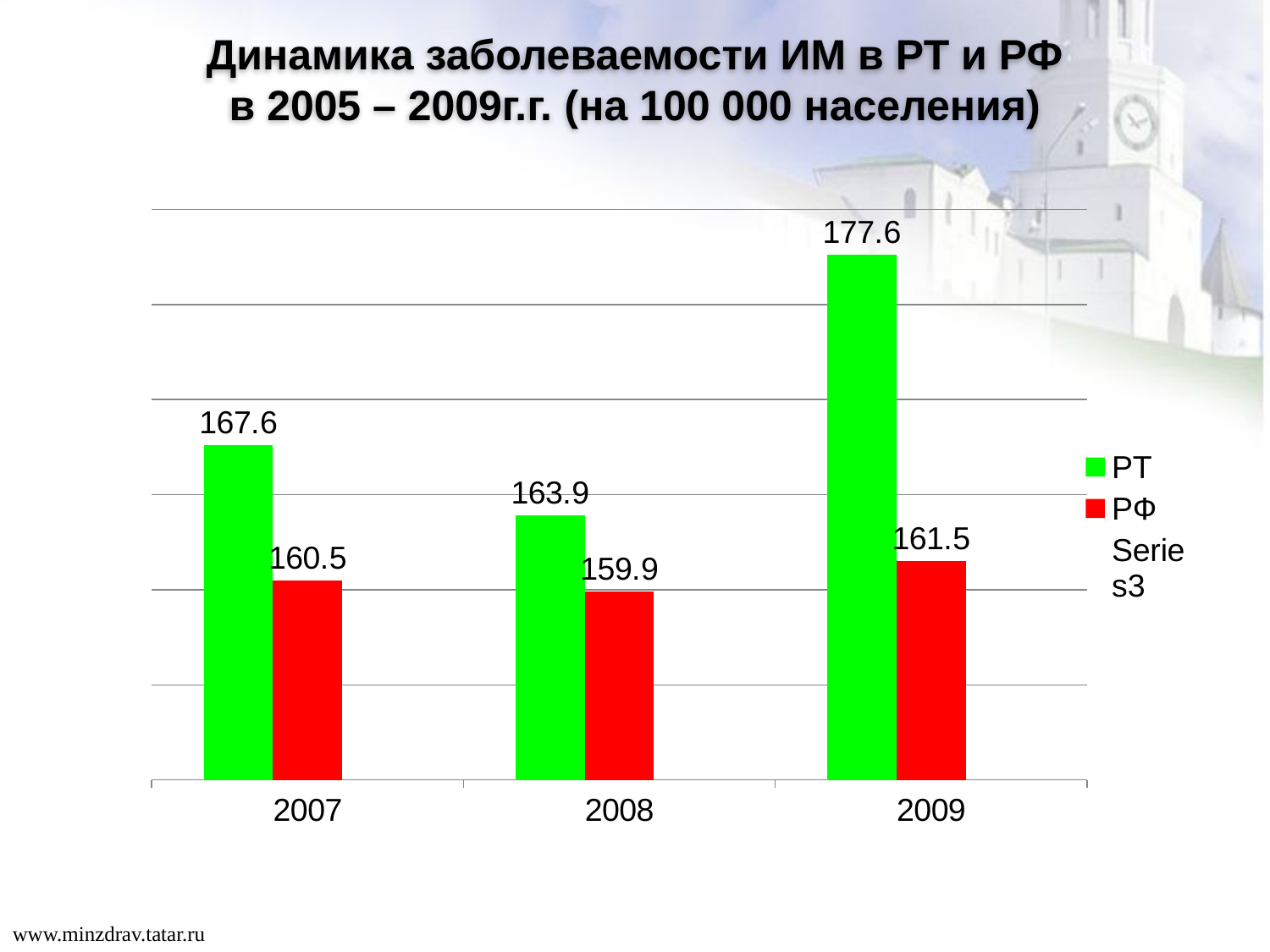
What kind of chart is shown on the slide? Bar chart In which year is the РФ value lowest? 2008 What is the value for РТ in 2009? 177.6 In which year is the РТ value highest? 2009 What is the value for РФ in 2008? 159.9 What is the value for РФ in 2007? 160.5 How many entries does the legend list? 3 Which is larger in 2007, the РТ value or the РФ value? РТ What is the difference between the РТ values in 2009 and 2008? 13.7 What is the value for РТ in 2008? 163.9 How many years are shown on the x axis? 3 What is the difference between the РТ and РФ values in 2009? 16.1